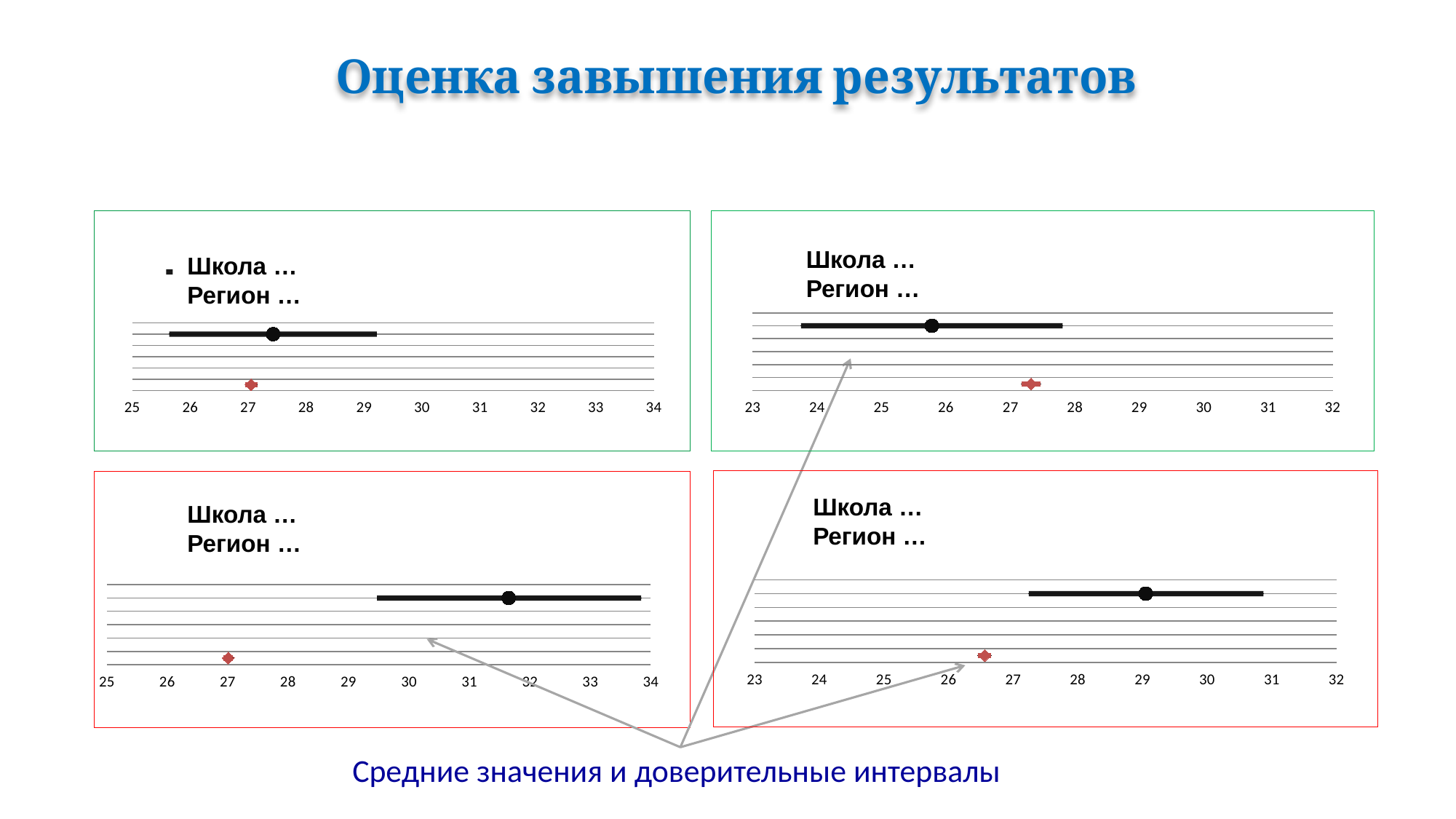
What is the title of the slide containing the four charts? Оценка завышения результатов In the top-left chart, how many series does the legend list? 2 In the top-right chart, is the value for Школа … greater or less than 27? less In the bottom-left chart, is the value for Регион … greater or less than 28? less In the top-right chart, which is larger, the value for Школа … or the value for Регион …? Регион … In the bottom-left chart, what are the two legend entries? Школа … and Регион … In the bottom-left chart, is the value for Школа … greater or less than 30? greater How many charts are shown on the slide? 4 In the bottom-right chart, which is larger, the value for Школа … or the value for Регион …? Школа … In the bottom-left chart, which is larger, the value for Школа … or the value for Регион …? Школа …